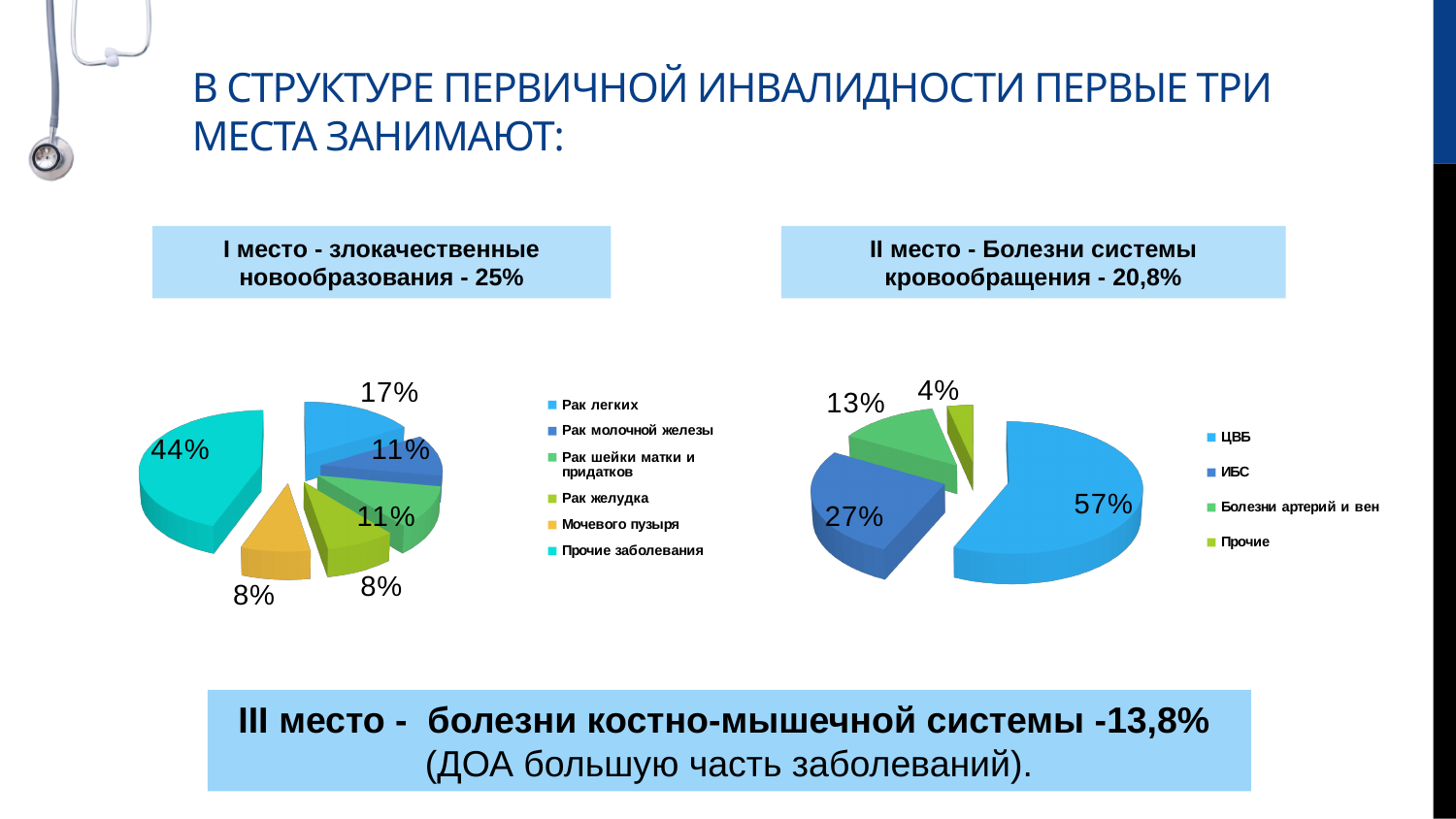
In the right pie chart, what share is shown for ЦВБ? 57% In the left pie chart, what share is shown for Рак легких? 17% In the right pie chart, which category has the smallest share? Прочие In the right pie chart, what is the difference between the shares of ЦВБ and ИБС? 30% In the left pie chart, which category has the largest share? Прочие заболевания In the left pie chart, which is larger: the share for Рак легких or the share for Рак желудка? Рак легких How many categories does the legend of the left pie chart list? 6 In the right pie chart, what share is shown for ИБС? 27% In the left pie chart, what share is shown for Прочие заболевания? 44% How many categories does the legend of the right pie chart list? 4 In the right pie chart, what share is shown for Болезни артерий и вен? 13% What type of chart is used on the left side of the slide? Pie chart